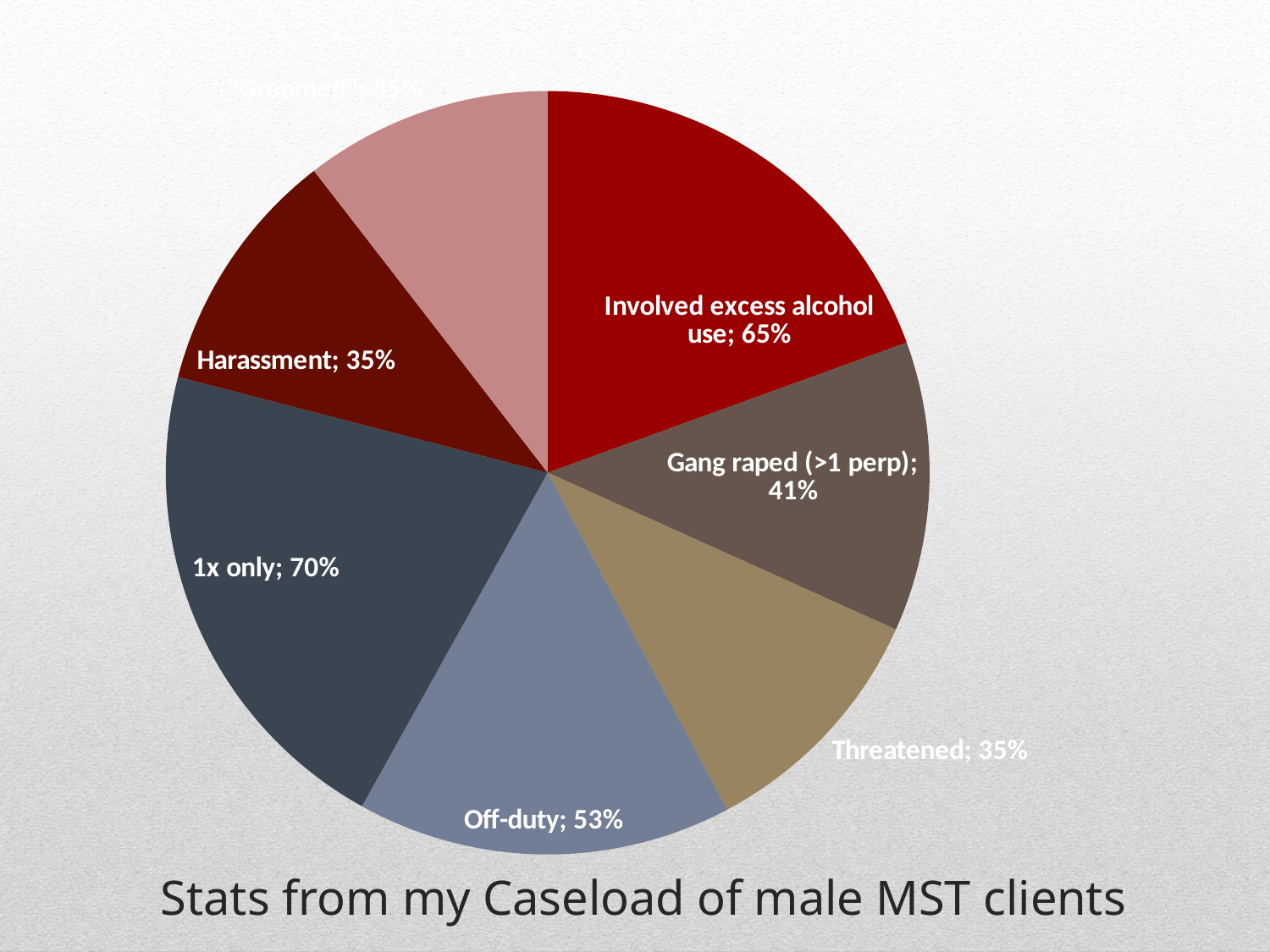
What is the difference between the values for "1x only" and "Off-duty"? 17% Which is larger, the value for "Involved excess alcohol use" or the value for "Off-duty"? Involved excess alcohol use How many slices does the pie chart have? 7 What value is shown for "1x only"? 70% What value is shown for "Gang raped (>1 perp)"? 41% What is the title of the slide? Stats from my Caseload of male MST clients What value is shown for "Involved excess alcohol use"? 65% What value is shown for "Off-duty"? 53% What value is shown for "Threatened"? 35% Which category has the highest value in the pie chart? 1x only What kind of chart is shown on the slide? pie chart What value is shown for "Harassment"? 35%